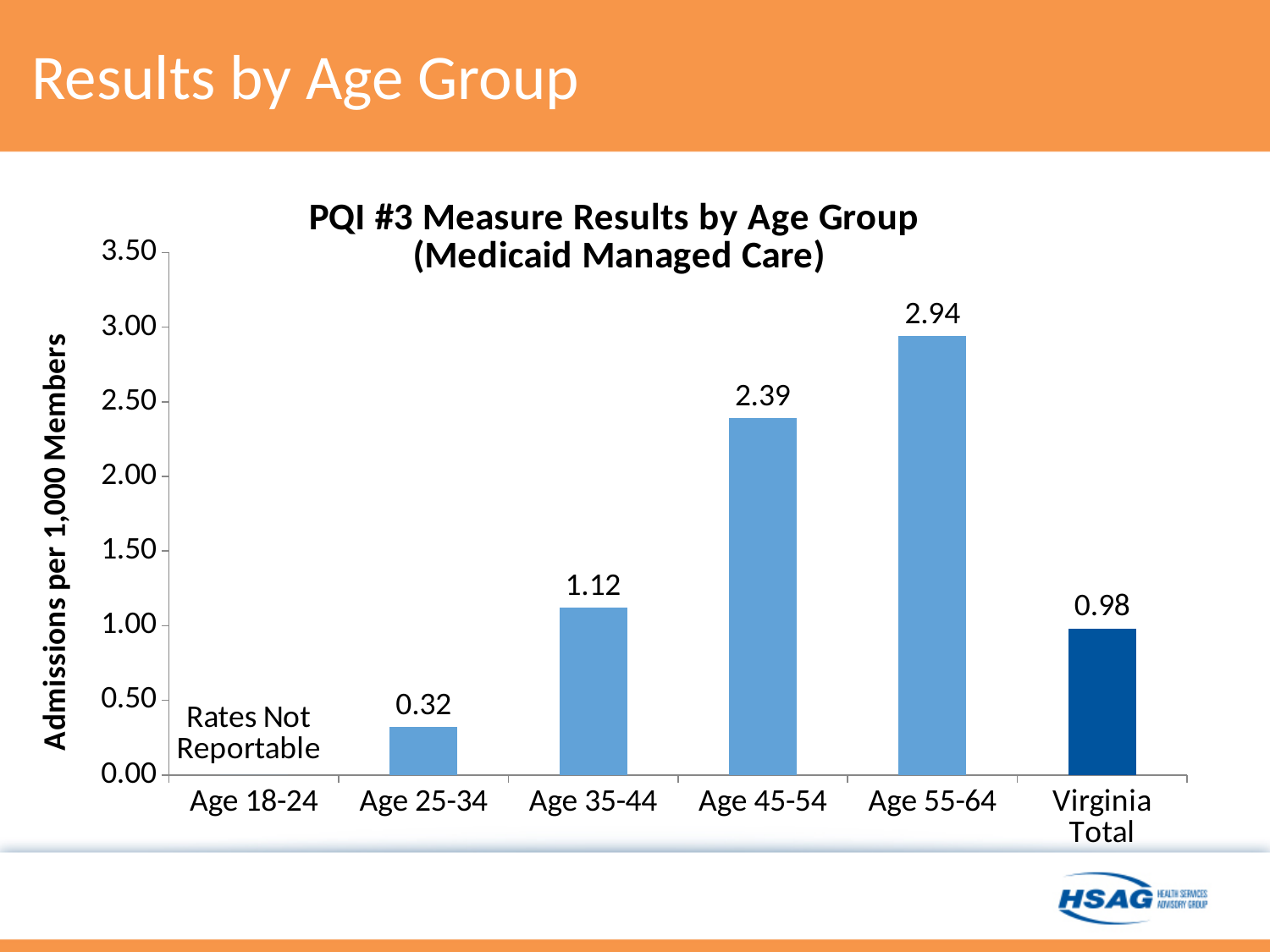
How many categories are shown on the x axis? 6 What is the value for Age 25-34? 0.32 What kind of chart is shown on the slide? bar chart What text appears in place of a bar for Age 18-24? Rates Not Reportable Is the value for Age 45-54 greater or less than 2.00? greater Which age group has the highest admissions per 1,000 members? Age 55-64 Do the values rise or fall from Age 25-34 to Age 55-64? rise What is the value for Age 55-64? 2.94 Which is larger, the value for Age 35-44 or the value for Virginia Total? Age 35-44 Which category with a plotted bar has the lowest value? Age 25-34 What is the difference between the values for Age 55-64 and Age 45-54? 0.55 What is the value for Virginia Total? 0.98